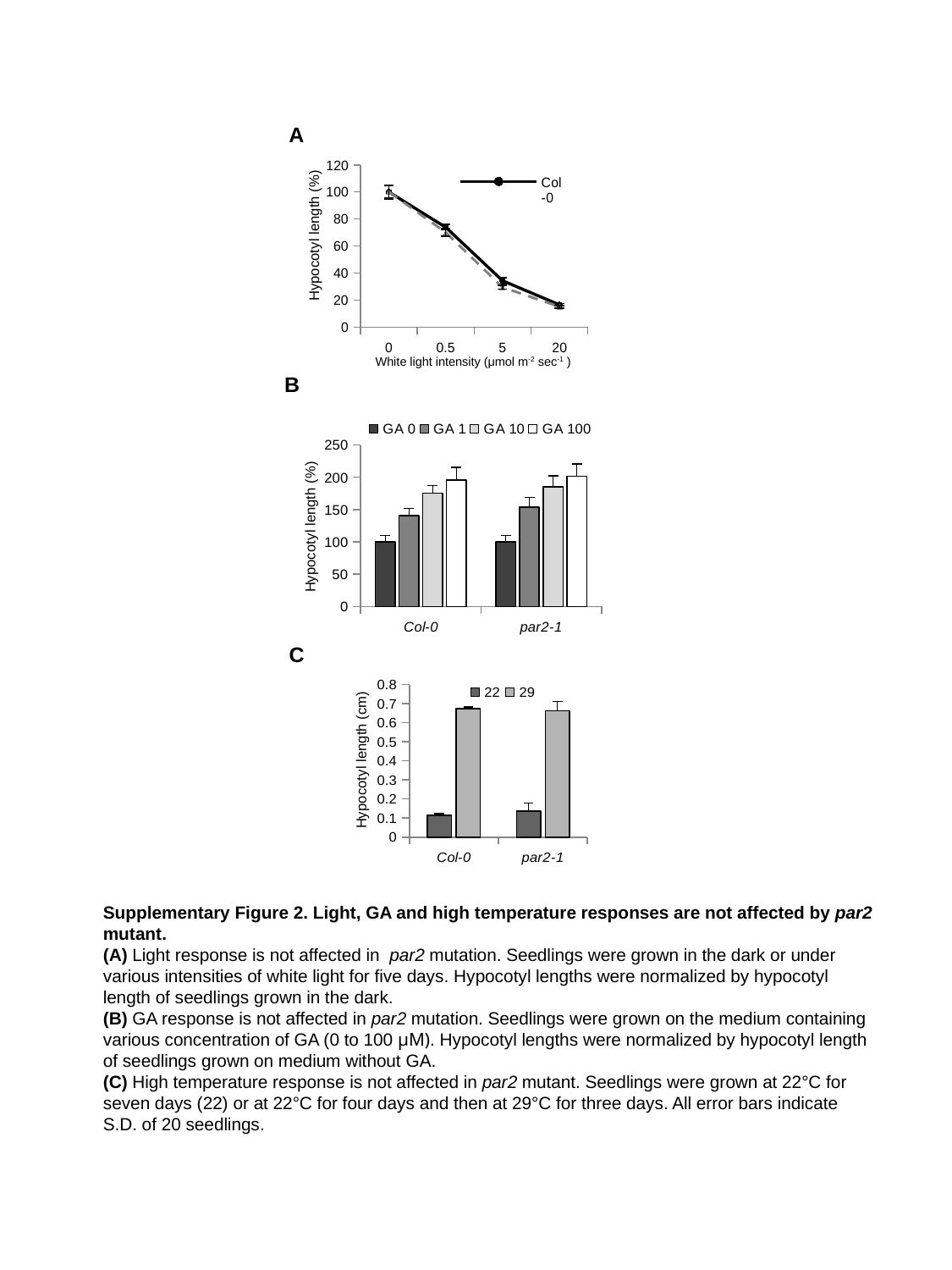
In chart C, is the value for the 29 series for Col-0 greater or less than 0.5? greater In chart B, which GA treatment gives the highest hypocotyl length for Col-0? GA 100 What kind of chart is chart B? bar chart How many series does the legend of chart B list? 4 What kind of chart is chart A? line chart How many series does the legend of chart C list? 2 In chart B, is the GA 10 value for Col-0 greater or less than 150? greater How many white light intensity points are plotted along the x axis in chart A? 4 In chart B, which is larger for par2-1: the GA 0 value or the GA 100 value? GA 100 In chart C, which series has the lower hypocotyl length for par2-1? 22 In chart A, do hypocotyl length values rise or fall as white light intensity increases along the x axis? fall In chart A, is the hypocotyl length at white light intensity 20 greater or less than 40? less